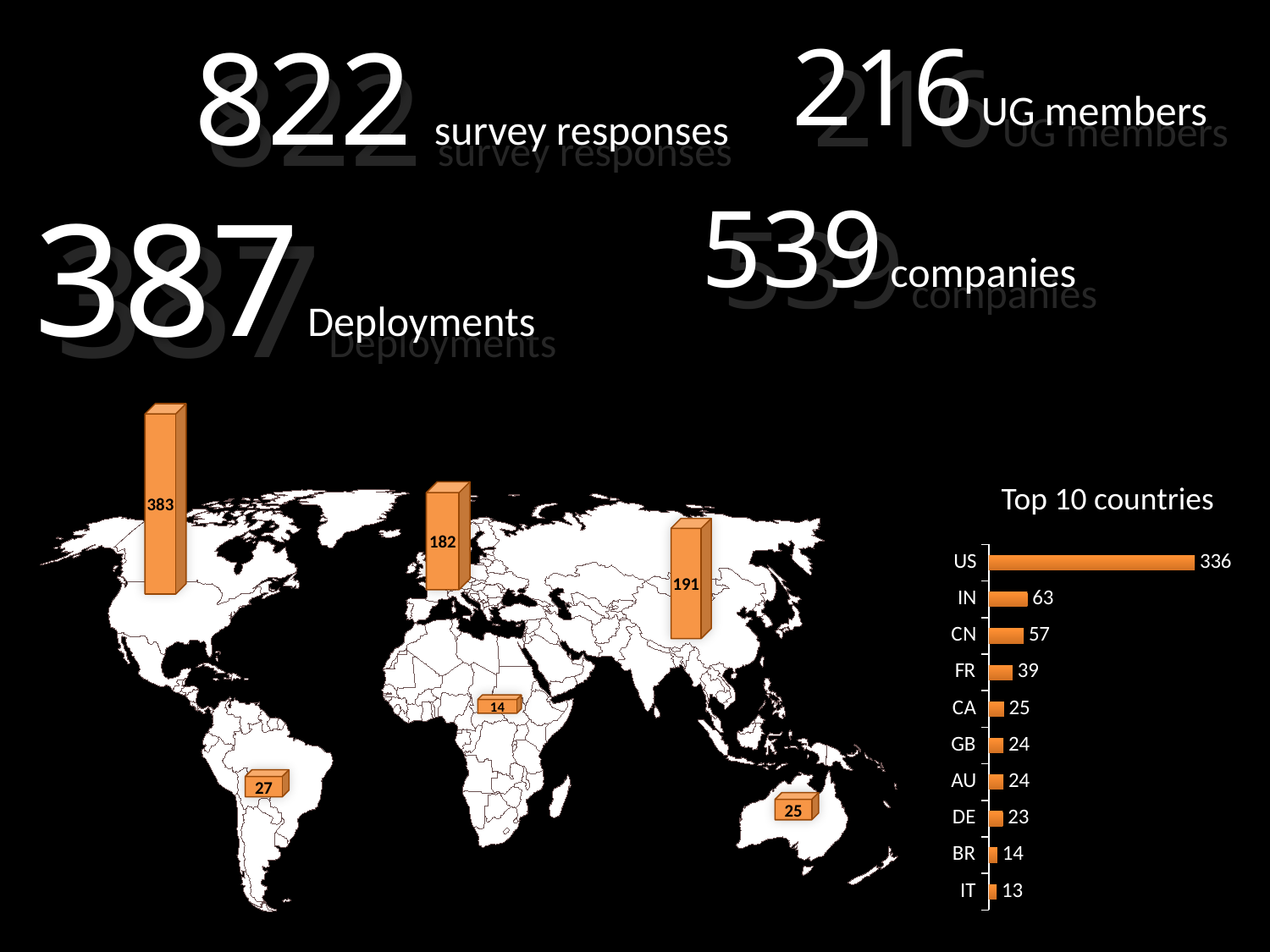
In the 'Top 10 countries' chart, what is the value for FR? 39 In the 'Top 10 countries' chart, what is the value for CN? 57 In the map chart, what is the value of the bar placed over North America? 383 In the 'Top 10 countries' chart, which country has the highest value? US In the 'Top 10 countries' chart, which is larger, the value for FR or the value for CA? FR What kind of chart is the 'Top 10 countries' chart? Bar chart In the 'Top 10 countries' chart, what is the difference between the values for IN and CN? 6 In the 'Top 10 countries' chart, what is the difference between the values for US and IN? 273 In the map chart, what is the value of the bar placed over Australia? 25 In the 'Top 10 countries' chart, what is the value for US? 336 In the 'Top 10 countries' chart, which country has the lowest value? IT How many countries are shown in the 'Top 10 countries' chart? 10